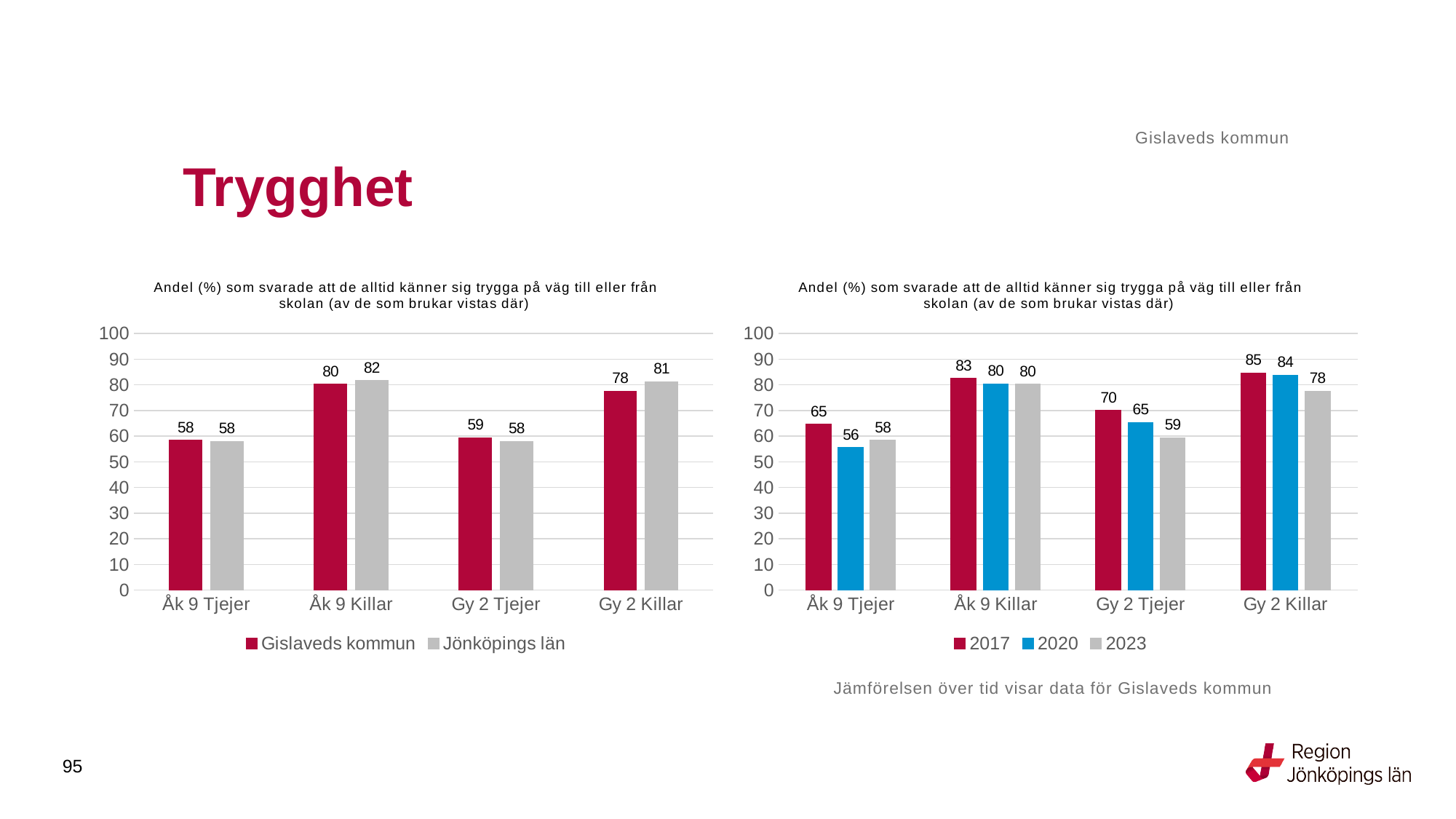
In the left chart, what is the difference between Jönköpings län and Gislaveds kommun for Åk 9 Killar? 2 In the left chart, what is the value for Jönköpings län for Gy 2 Killar? 81 In the left chart, which category has the lowest value for Gislaveds kommun? Åk 9 Tjejer In the right chart, is the 2017 value for Gy 2 Tjejer larger or the 2020 value for Gy 2 Tjejer? 2017 In the right chart, what is the difference between the 2017 and 2023 values for Gy 2 Tjejer? 11 In the right chart, what is the value for 2023 for Gy 2 Killar? 78 In the right chart, which category has the highest value for 2017? Gy 2 Killar What kind of chart is the right chart? Bar chart In the left chart, what is the value for Gislaveds kommun for Åk 9 Killar? 80 In the left chart, how many series does the legend list? 2 In the right chart, what is the value for 2020 for Åk 9 Tjejer? 56 In the right chart, how many categories are shown on the x axis? 4